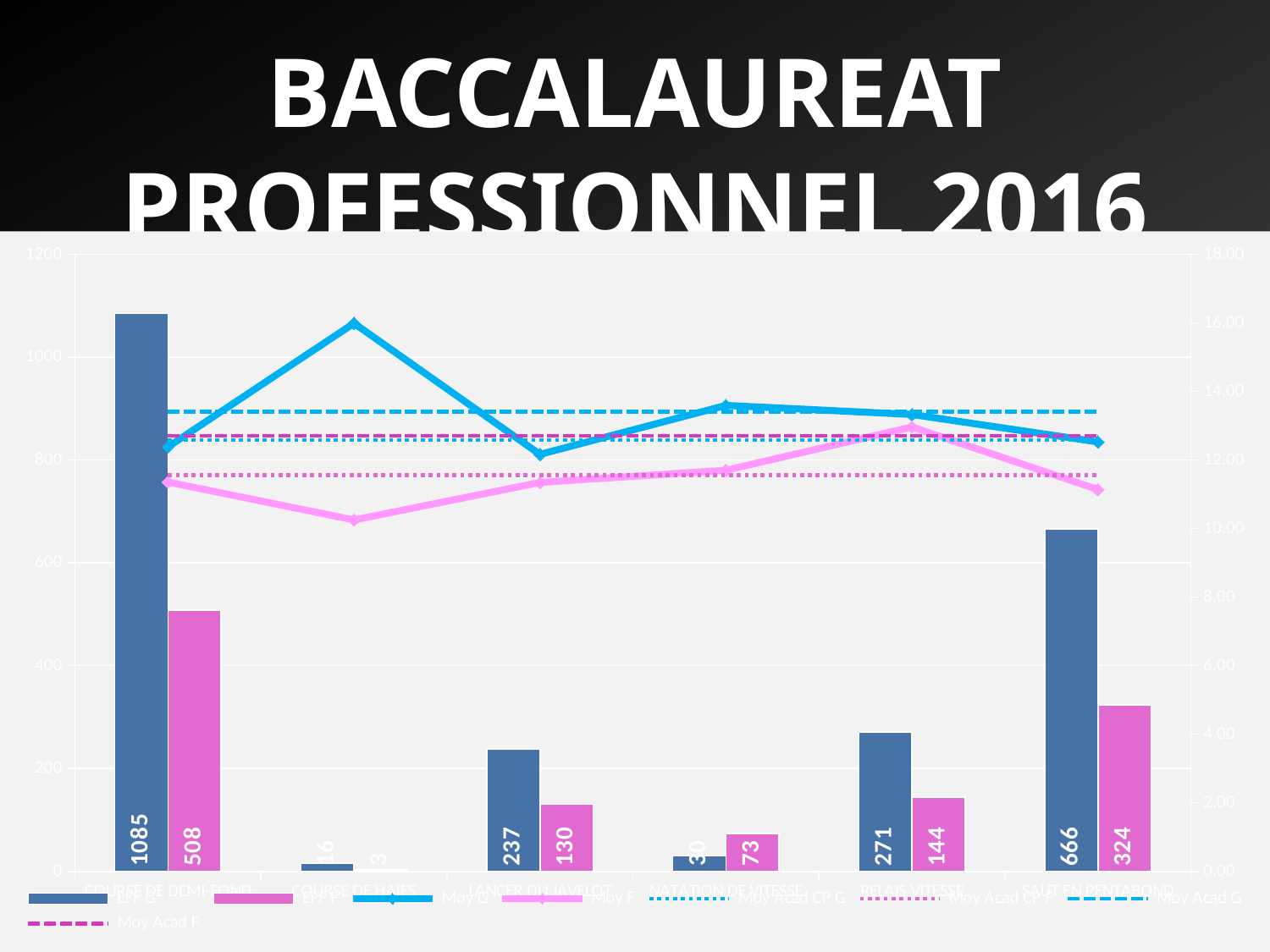
Which category has the highest Eff G value? COURSE DE DEMI-FOND What is the difference between Eff G and Eff F for COURSE DE DEMI-FOND? 577 Is the Moy F value for COURSE DE HAIES greater or less than 12.00 on the right axis? less Which category has the lowest Eff F value? COURSE DE HAIES Is the Moy G value for COURSE DE HAIES greater or less than 14.00 on the right axis? greater For NATATION DE VITESSE, which is larger, Eff G or Eff F? Eff F What is the Eff F value for SAUT EN PENTABOND? 324 How many series does the legend list? 8 What is the Eff G value for RELAIS VITESSE? 271 How many categories are shown on the x axis? 6 What is the difference between Eff G and Eff F for SAUT EN PENTABOND? 342 What is the Eff G value for COURSE DE DEMI-FOND? 1085